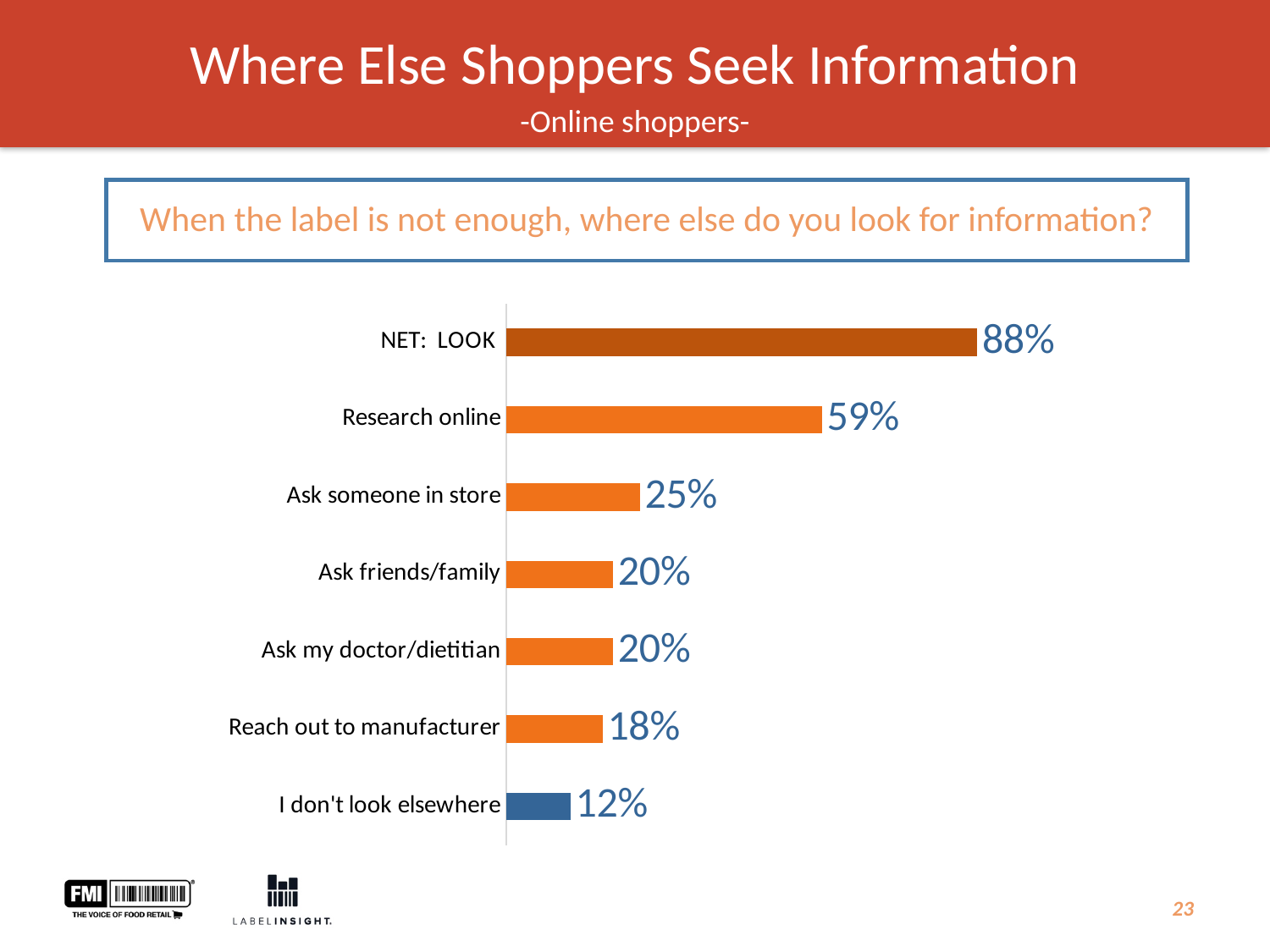
What is the value for 'Ask someone in store'? 25% Which category has the lowest value on the chart? I don't look elsewhere Which is larger: 'Ask friends/family' or 'Reach out to manufacturer'? Ask friends/family Which bar on the chart is coloured blue rather than orange? I don't look elsewhere What percentage of online shoppers research online when the label is not enough? 59% What is the value for 'NET: LOOK'? 88% What kind of chart is shown on the slide? Bar chart How many categories are shown on the chart? 7 What percentage of online shoppers say they don't look elsewhere? 12% What is the difference between 'Research online' and 'Ask someone in store'? 34% Excluding the NET: LOOK bar, which category has the highest value? Research online What is the difference between 'Reach out to manufacturer' and 'I don't look elsewhere'? 6%